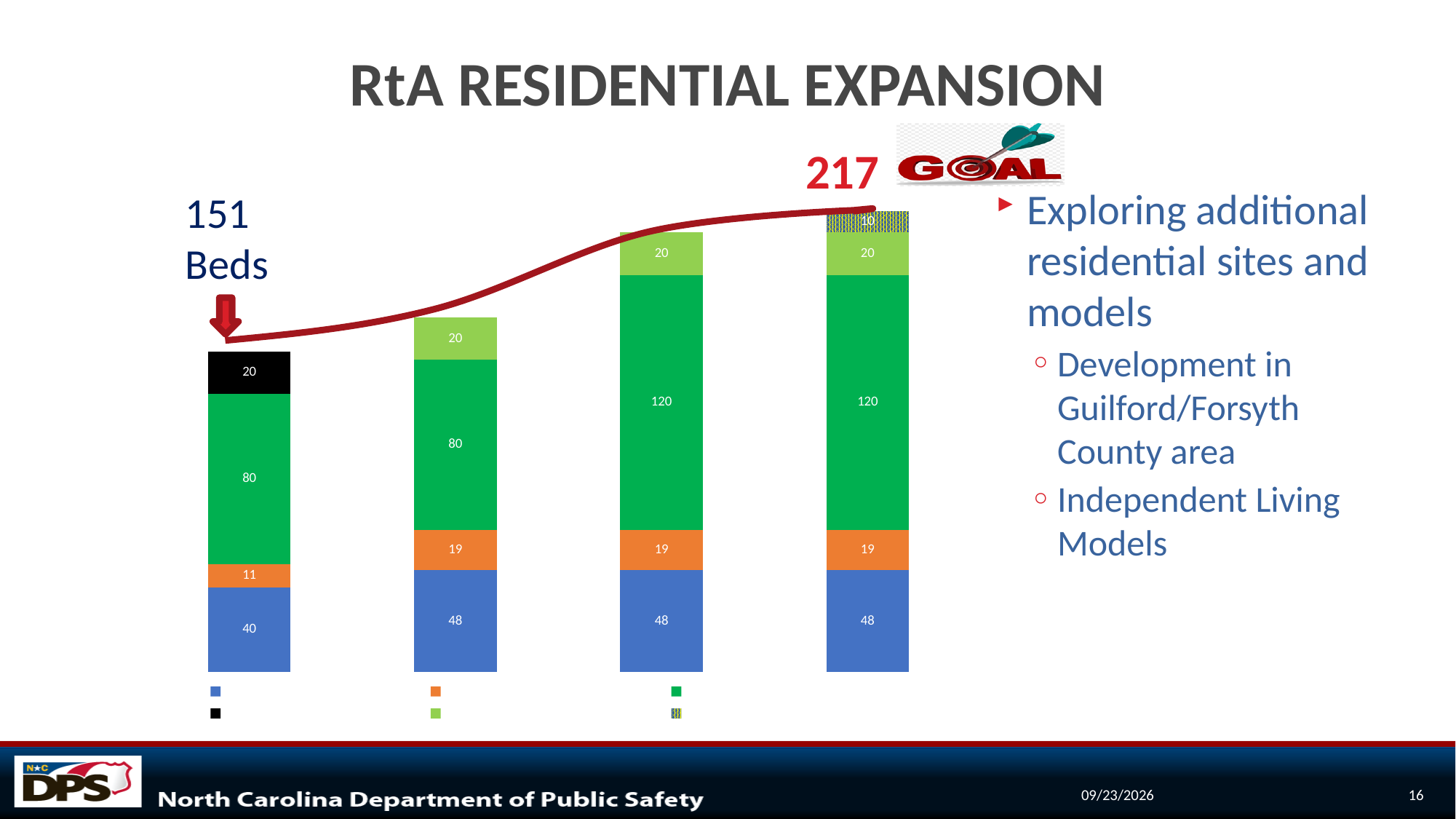
What is the value of the blue segment in the leftmost bar? 40 What is the value of the black segment in the leftmost bar? 20 What kind of chart is shown on the slide? Stacked bar chart What is the value of the dark green segment in the third bar from the left? 120 What is the total of the rightmost bar? 217 Which bar has the highest total? The rightmost bar How many series does the legend list? 6 What is the value of the orange segment in the leftmost bar? 11 How many bars are plotted in the chart? 4 What is the total of the second bar from the left? 167 What is the difference between the dark green segment in the third bar and the dark green segment in the first bar? 40 Do the bar totals rise or fall from left to right? Rise